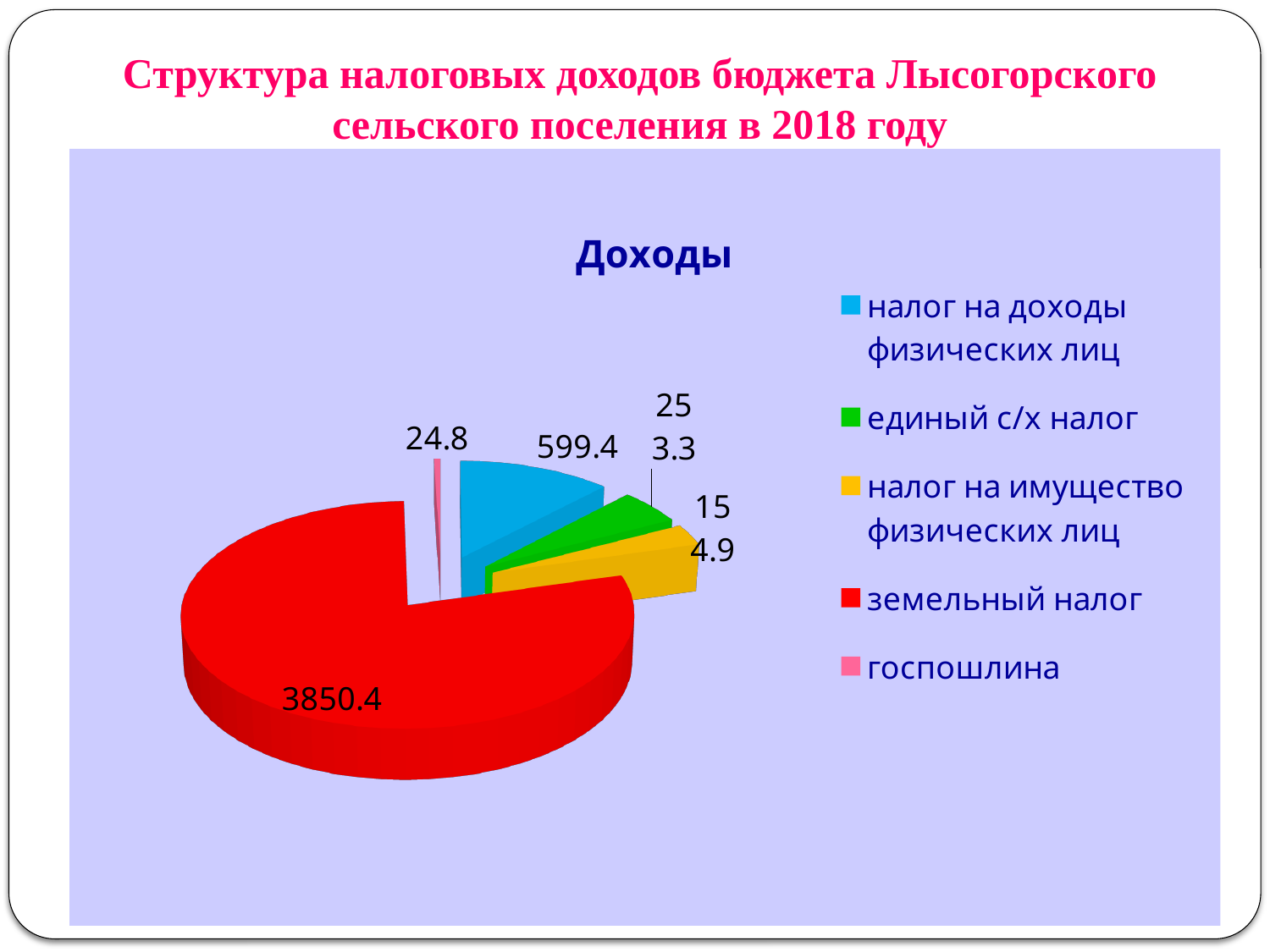
What colour is the slice for земельный налог? red What is the difference between the values for земельный налог and налог на доходы физических лиц? 3251 What is the value for госпошлина? 24.8 What is the title of the chart? Доходы Which category has the largest slice of the pie? земельный налог What kind of chart is shown on the slide? pie chart Which category has the smallest slice of the pie? госпошлина How many categories does the legend list? 5 What is the value for налог на доходы физических лиц? 599.4 Which is larger, земельный налог or налог на доходы физических лиц? земельный налог What is the difference between the values for налог на доходы физических лиц and госпошлина? 574.6 What is the value for земельный налог? 3850.4